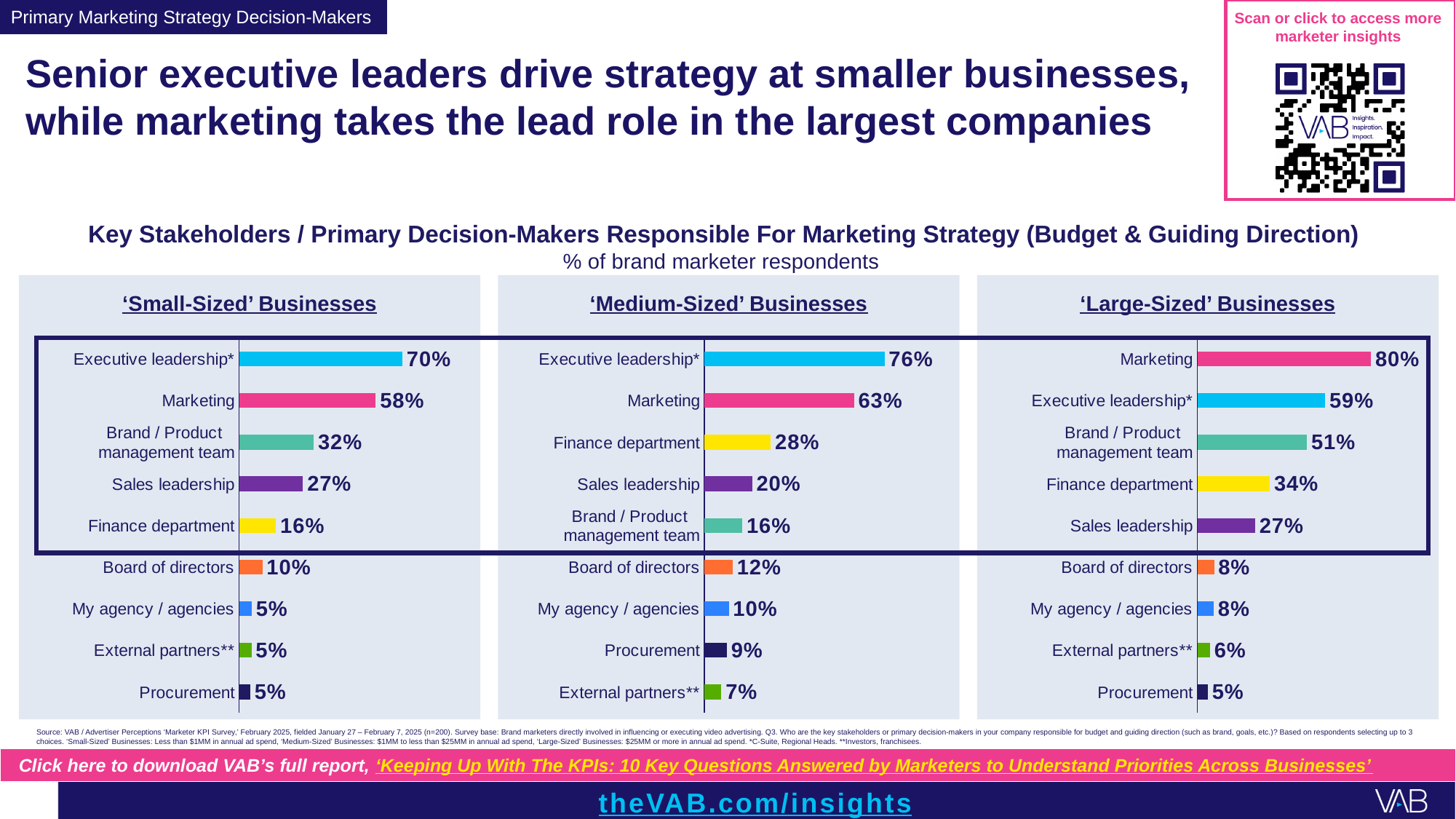
In the 'Medium-Sized' Businesses chart, which is larger: Sales leadership or Brand / Product management team? Sales leadership How many categories are shown in the 'Small-Sized' Businesses chart? 9 In the 'Large-Sized' Businesses chart, what is the difference between Marketing and Executive leadership*? 21% What kind of chart is used for the 'Medium-Sized' Businesses data? Bar chart In the 'Large-Sized' Businesses chart, what percentage is shown for Board of directors? 8% In the 'Large-Sized' Businesses chart, what percentage is shown for Brand / Product management team? 51% In the 'Medium-Sized' Businesses chart, what percentage is shown for Finance department? 28% What colour is the Marketing bar in each of the three charts? Pink In the 'Large-Sized' Businesses chart, which category has the highest value? Marketing In the 'Small-Sized' Businesses chart, what is the difference between Executive leadership* and Marketing? 12% In the 'Medium-Sized' Businesses chart, which category has the lowest value? External partners** In the 'Small-Sized' Businesses chart, what percentage is shown for Executive leadership*? 70%